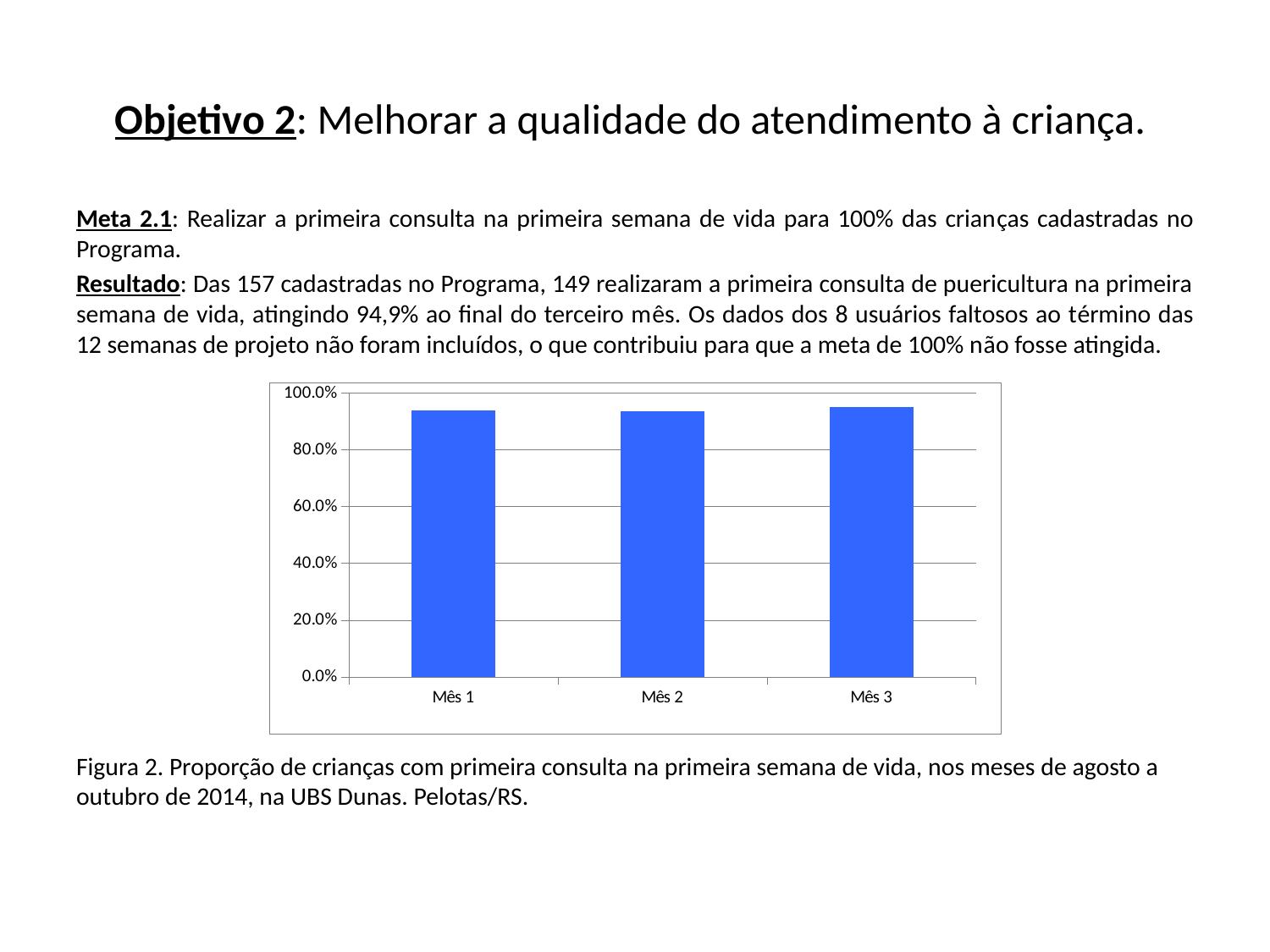
What is the highest tick value shown on the vertical axis of the chart? 100.0% Is the value for Mês 2 greater or less than 40.0%? greater Is the value for Mês 3 greater or less than 100.0%? less What kind of chart is shown on the slide? bar chart Is the value for Mês 1 greater or less than 80.0%? greater What is the label of the first category on the horizontal axis? Mês 1 How many categories (months) are plotted on the chart? 3